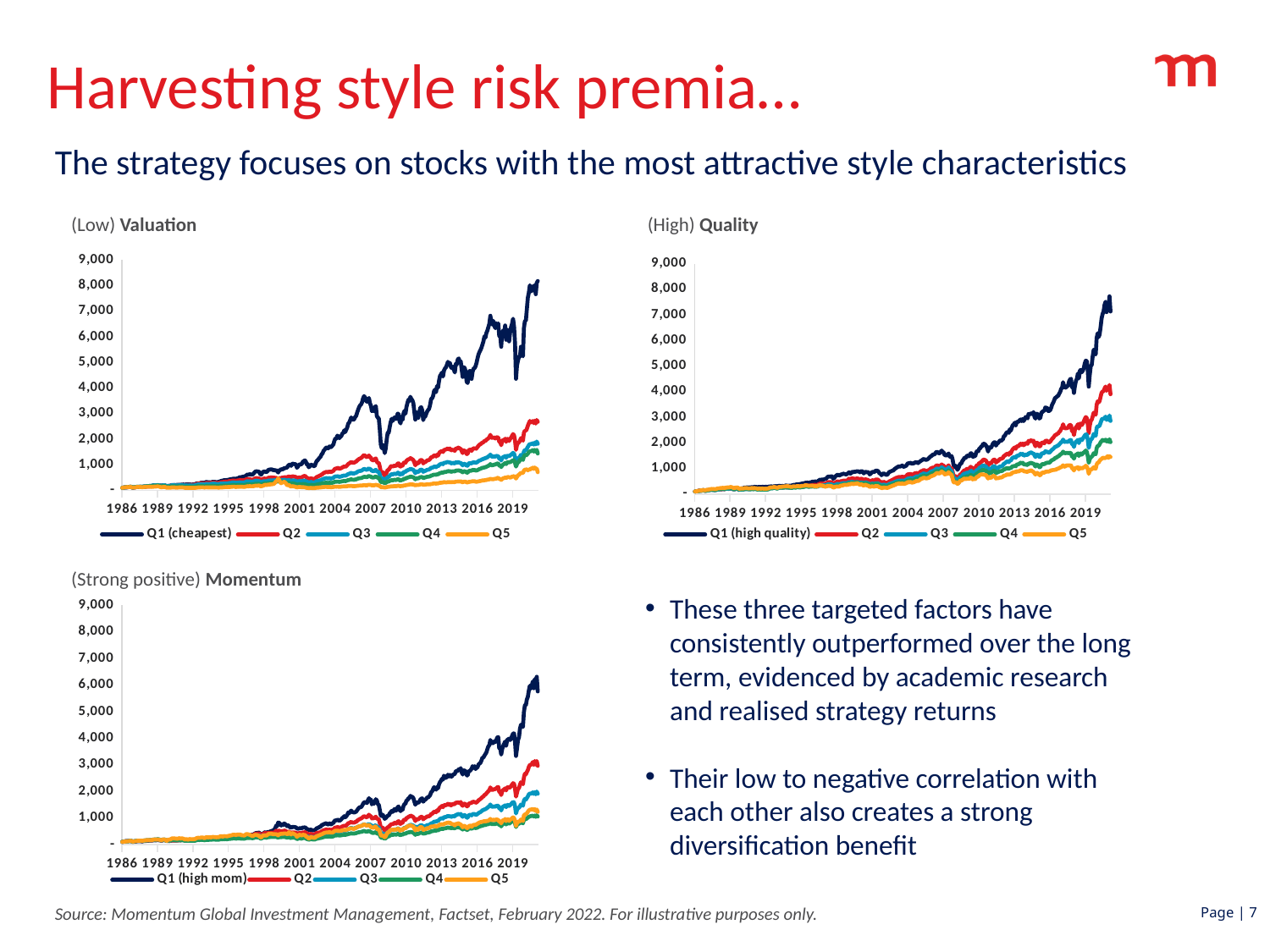
In the (Low) Valuation chart, which series reaches the highest value at the end of the period? Q1 (cheapest) In the (Strong positive) Momentum chart, is the final value of Q1 (high mom) greater or less than 5,000? greater In the (Strong positive) Momentum chart, what is the label of the first series in the legend? Q1 (high mom) In the (High) Quality chart, which series has the lowest value at the end of the period? Q5 In the (High) Quality chart, is the final value of Q1 (high quality) greater or less than 6,000? greater How many series does the legend of the (High) Quality chart list? 5 In the (Low) Valuation chart, does the Q1 (cheapest) series generally rise or fall from 1986 to the end of the period? rise In the (Low) Valuation chart, is the final value of Q1 (cheapest) greater or less than 7,000? greater In the (High) Quality chart, which is larger at the end of the period, Q2 or Q5? Q2 What kind of chart is the (Low) Valuation chart? line chart What is the first year shown on the x axis of the (Strong positive) Momentum chart? 1986